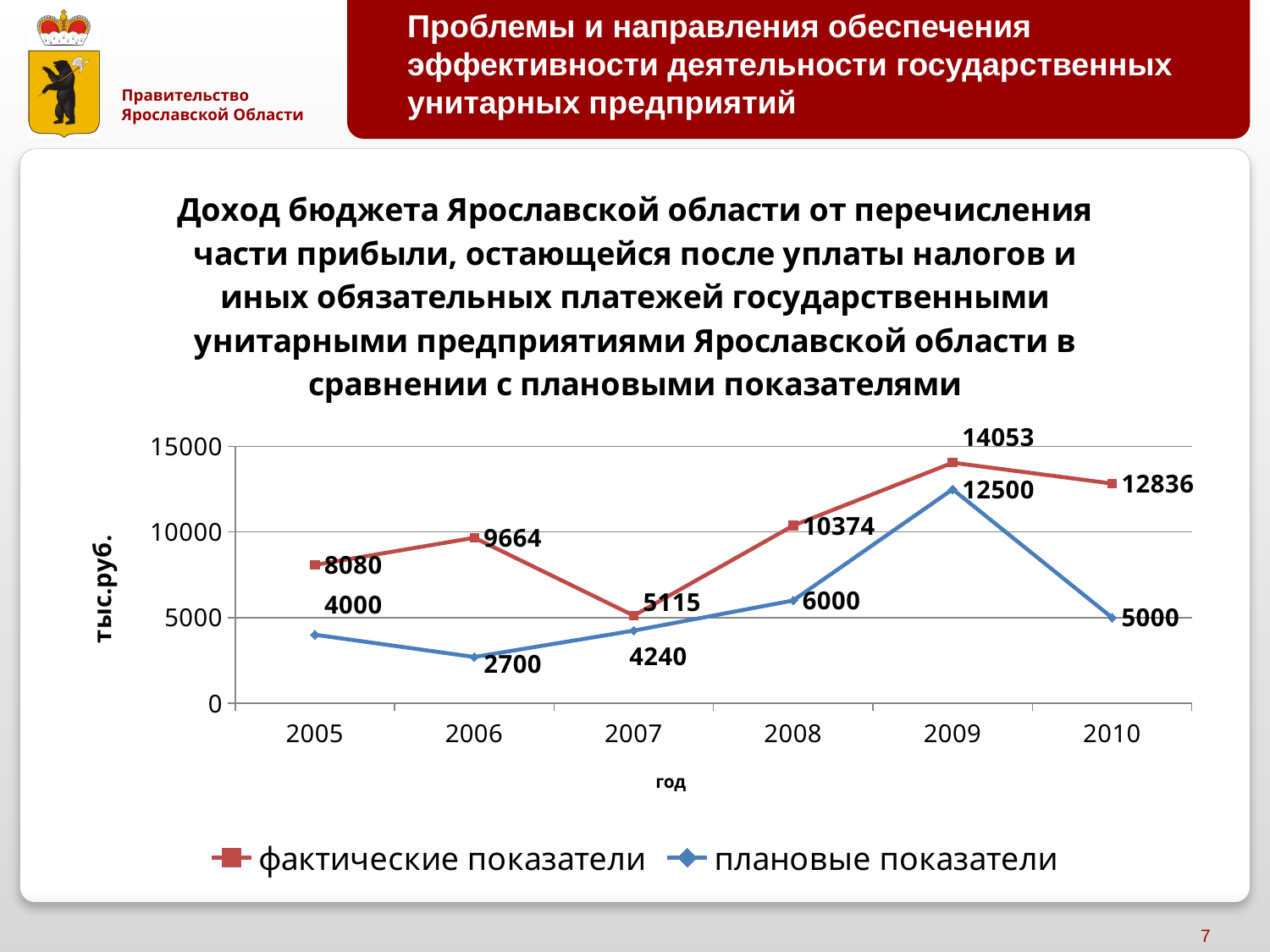
What is the value of фактические показатели in 2007? 5115 Which is larger in 2008: фактические показатели or плановые показатели? фактические показатели How many years are shown on the x axis? 6 What is the label of the y axis? тыс.руб. What is the value of плановые показатели in 2006? 2700 In which year is the value of плановые показатели highest? 2009 What type of chart is shown on the slide? line chart In which year is the value of фактические показатели lowest? 2007 What is the value of фактические показатели in 2009? 14053 Does the value of фактические показатели rise or fall from 2009 to 2010? fall What is the difference between фактические показатели and плановые показатели in 2010? 7836 How many series does the legend list? 2